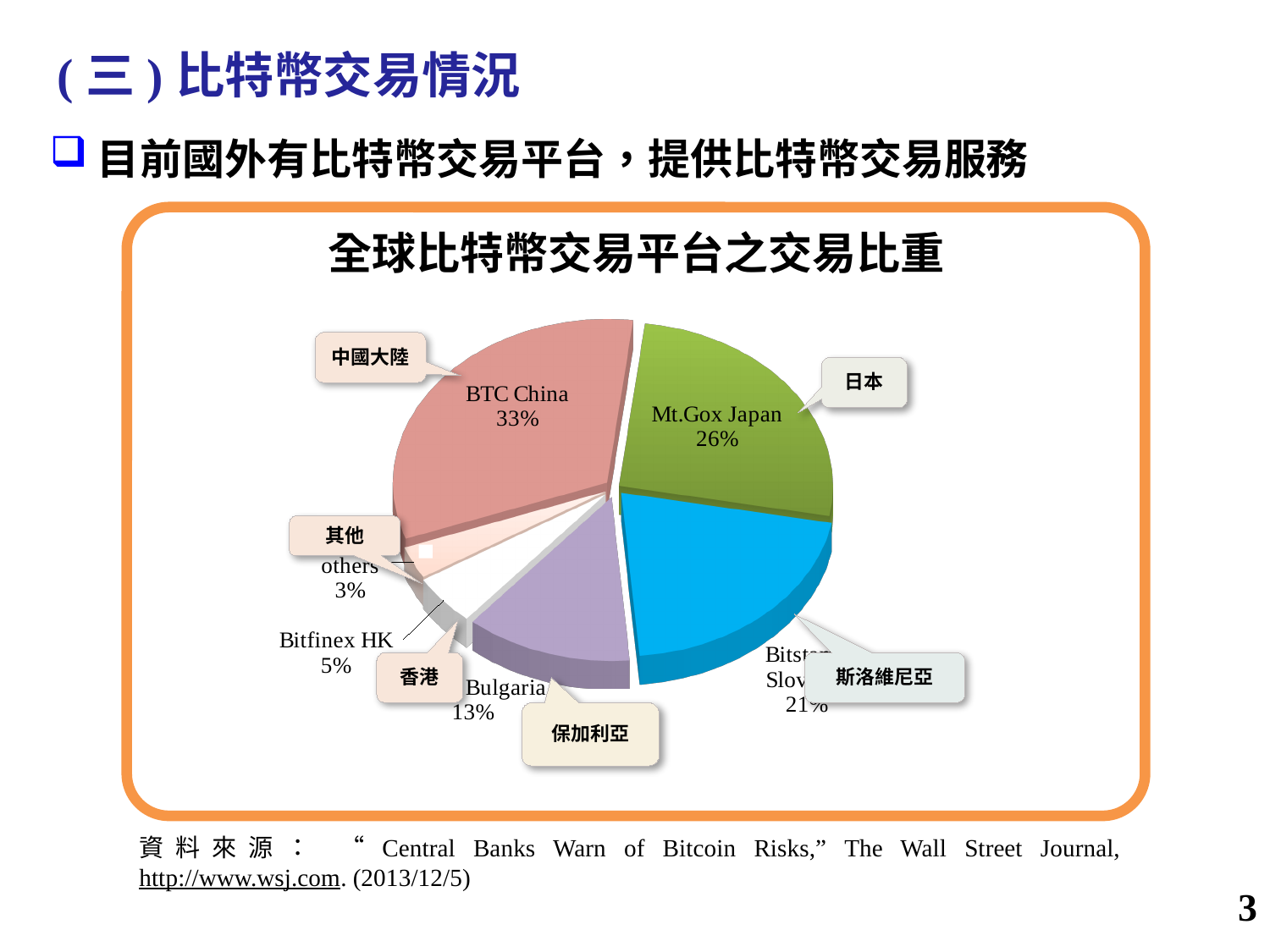
What is the difference in share between BTC China and Mt.Gox Japan? 7% How many slices does the pie chart have? 6 What share of the pie does the 'others' slice hold? 3% What share of the pie does Bulgaria hold? 13% What share of the pie does BTC China hold? 33% What share of the pie does Mt.Gox Japan hold? 26% What kind of chart is shown on the slide? pie chart Which slice has the smallest share of the pie? others What is the title of the chart? 全球比特幣交易平台之交易比重 What share of the pie does Bitfinex HK hold? 5% Which has a larger share, Bulgaria or Bitfinex HK? Bulgaria Which exchange has the largest share of the pie? BTC China